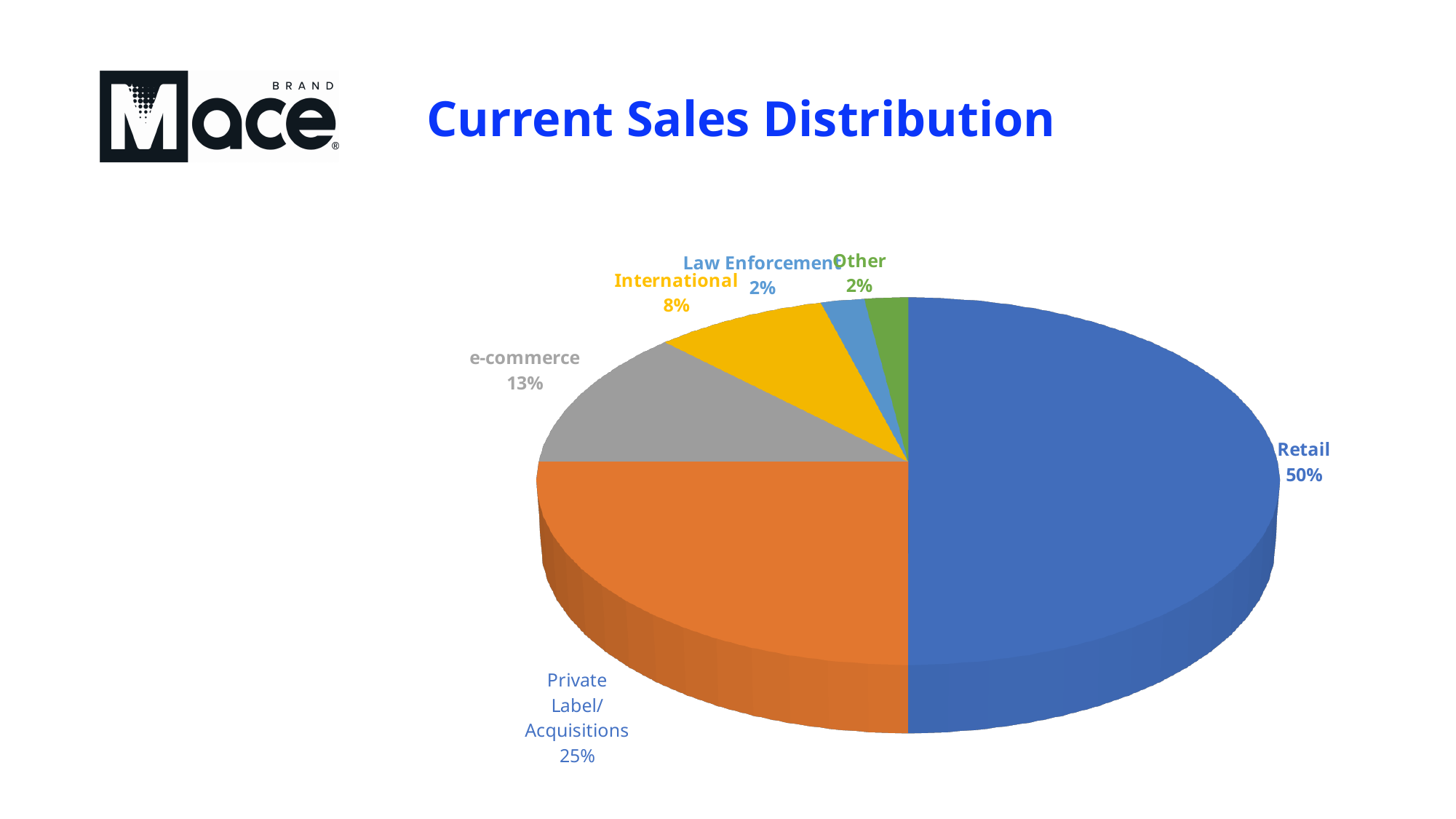
What share of sales does Retail account for? 50% What share of sales does Law Enforcement account for? 2% Which category has the largest share of sales? Retail What kind of chart is shown on the slide? Pie chart What share of sales does Private Label/Acquisitions account for? 25% What is the title of the chart? Current Sales Distribution What share of sales does e-commerce account for? 13% What share of sales does International account for? 8% What is the difference in share between e-commerce and International? 5% How many categories are shown in the pie chart? 6 What is the difference in share between Retail and Private Label/Acquisitions? 25% Which has a larger share, e-commerce or International? e-commerce